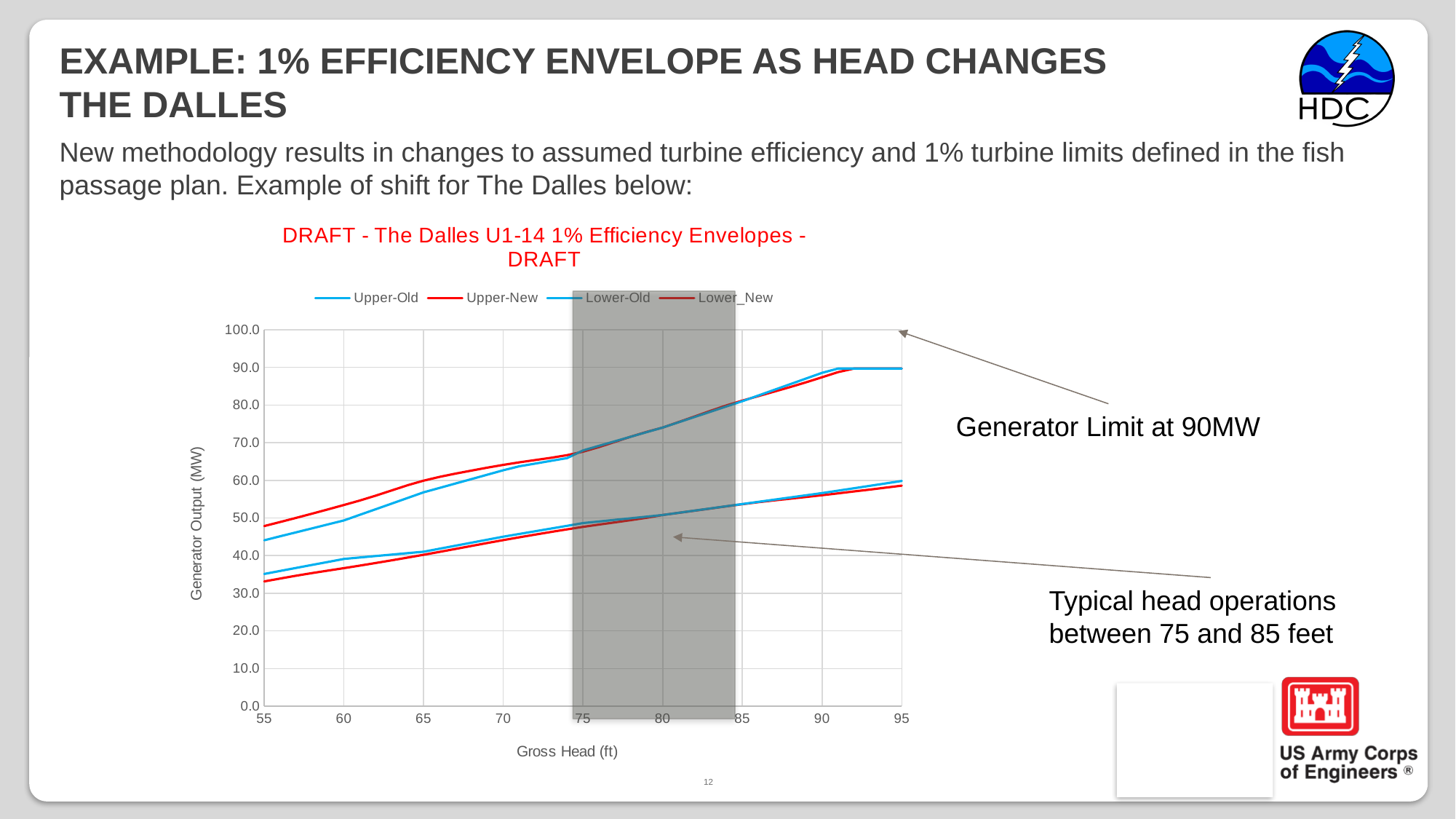
What is the title of the chart? DRAFT - The Dalles U1-14 1% Efficiency Envelopes - DRAFT Do the Upper-New values rise or fall as gross head increases from 55 to 90 ft? rise How many series does the chart legend list? 4 Is the Lower_New value at 55 ft gross head greater or less than 40? less At 55 ft gross head, which is larger: Upper-New or Upper-Old? Upper-New Is the Lower-Old value at 95 ft gross head greater or less than 50? greater What is the label of the x axis of the chart? Gross Head (ft) What kind of chart is shown on the slide? line chart How many tick labels are shown on the x axis of the chart? 9 At 55 ft gross head, which series has the lowest generator output? Lower_New Is the Upper-Old value at 55 ft gross head greater or less than 50? less